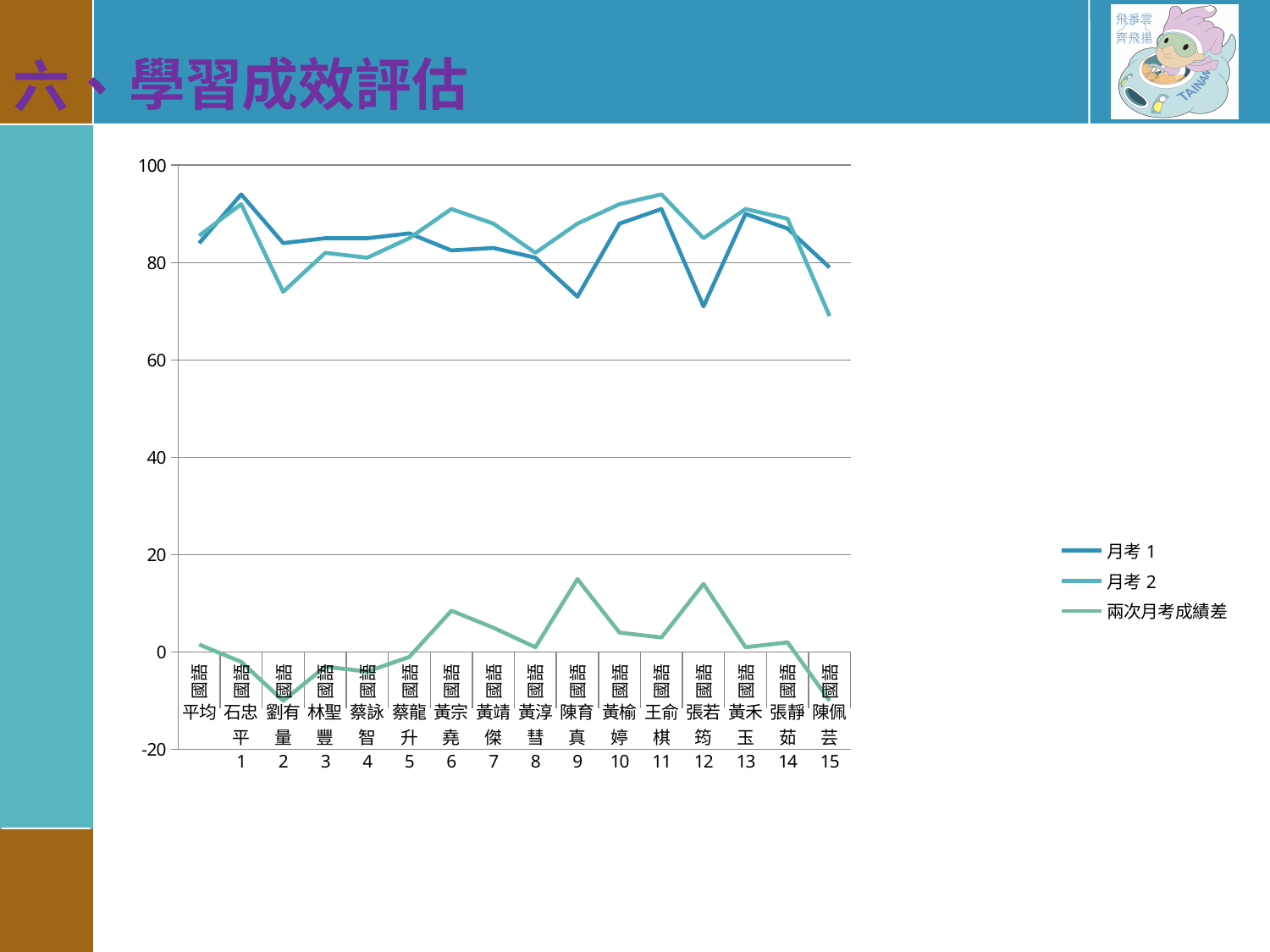
Is the 月考 1 value for 張若筠 greater or less than 80? less For 劉有量, which is larger: the 月考 1 value or the 月考 2 value? 月考 1 For 陳育真, which is larger: the 月考 1 value or the 月考 2 value? 月考 2 What kind of chart is shown on the slide? line chart Is the 月考 2 value for 劉有量 greater or less than 80? less Is the 兩次月考成績差 value for 陳育真 greater or less than 0? greater Which category has the highest value for 月考 1? 石忠平 Which category has the lowest value for 月考 2? 陳佩芸 What are the three series named in the legend? 月考 1, 月考 2, 兩次月考成績差 How many categories are plotted along the x axis? 16 How many series does the legend list? 3